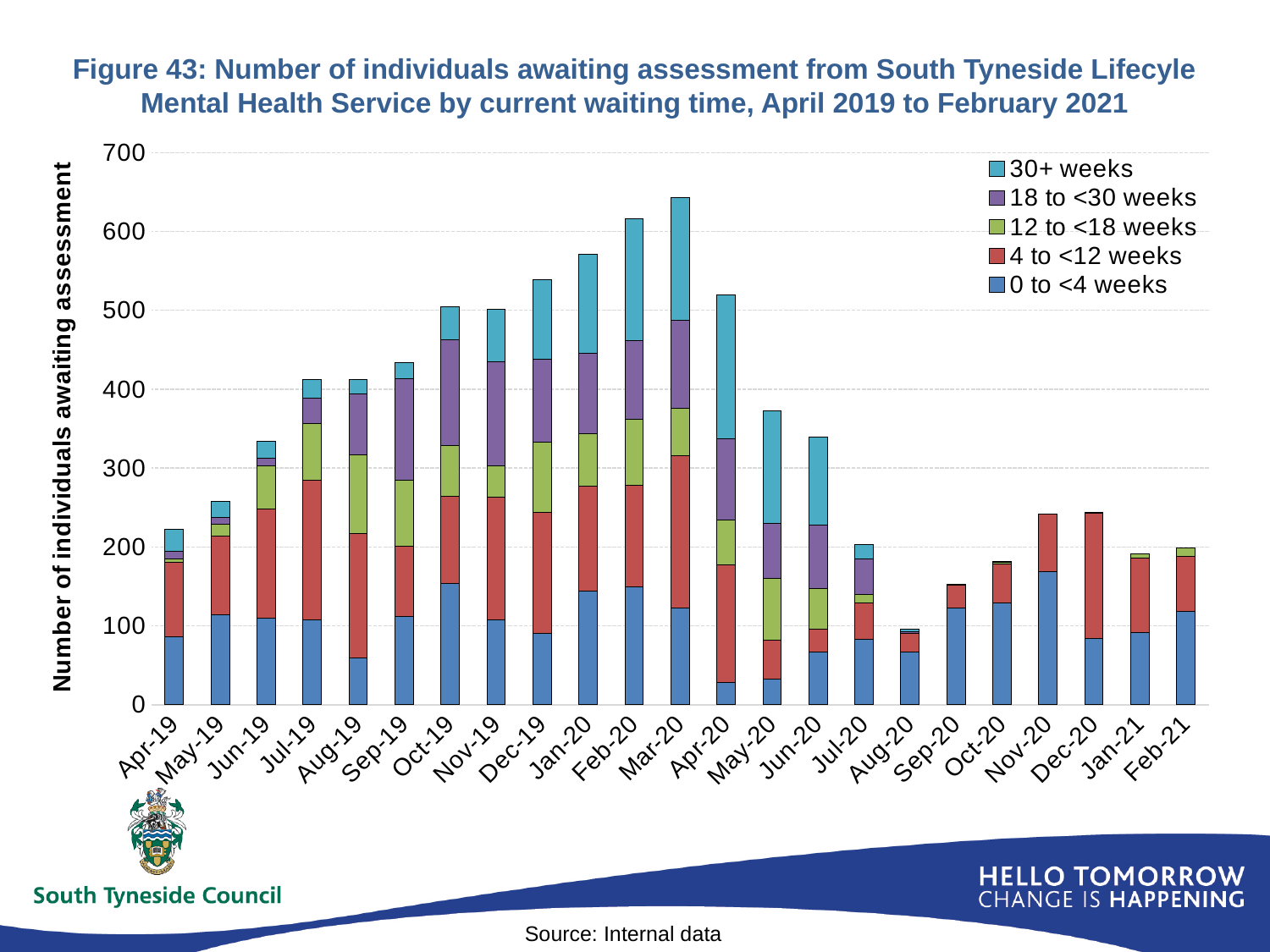
Do the total numbers awaiting assessment generally rise or fall from Apr-19 to Mar-20? rise Which month has the lowest total number of individuals awaiting assessment? Aug-20 Is the total number awaiting assessment in Sep-20 greater or less than 200? less Is the total number awaiting assessment in Mar-20 greater or less than 600? greater Which month has a larger total number awaiting assessment, Apr-20 or May-20? Apr-20 How many series does the legend list? 5 Which month has the highest total number of individuals awaiting assessment? Mar-20 How many months are shown along the x axis? 23 Which waiting-time category is listed first (at the top) in the legend? 30+ weeks What kind of chart is shown on the slide? Stacked bar chart